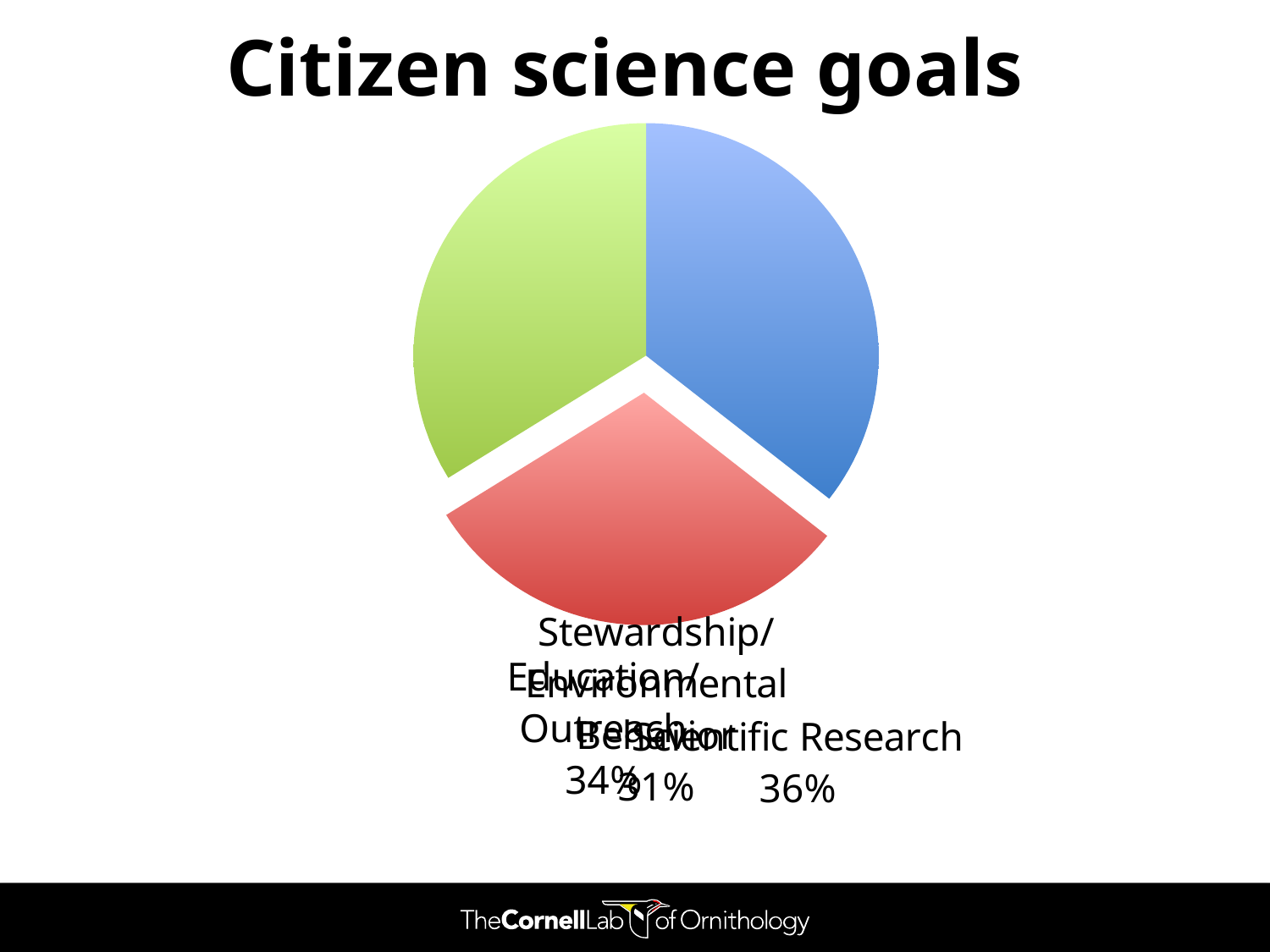
What is the largest percentage shown on the pie chart? 36% Which category has the largest share of the pie? Scientific Research What colour is the Scientific Research slice? blue What kind of chart is shown on the slide? pie chart What share of the pie is Scientific Research? 36% How many slices does the pie chart have? 3 Is the share for Scientific Research greater or less than 50%? less What is the difference between the largest and smallest percentages shown on the pie chart? 5% What is the smallest percentage shown on the pie chart? 31% What is the title of the chart? Citizen science goals